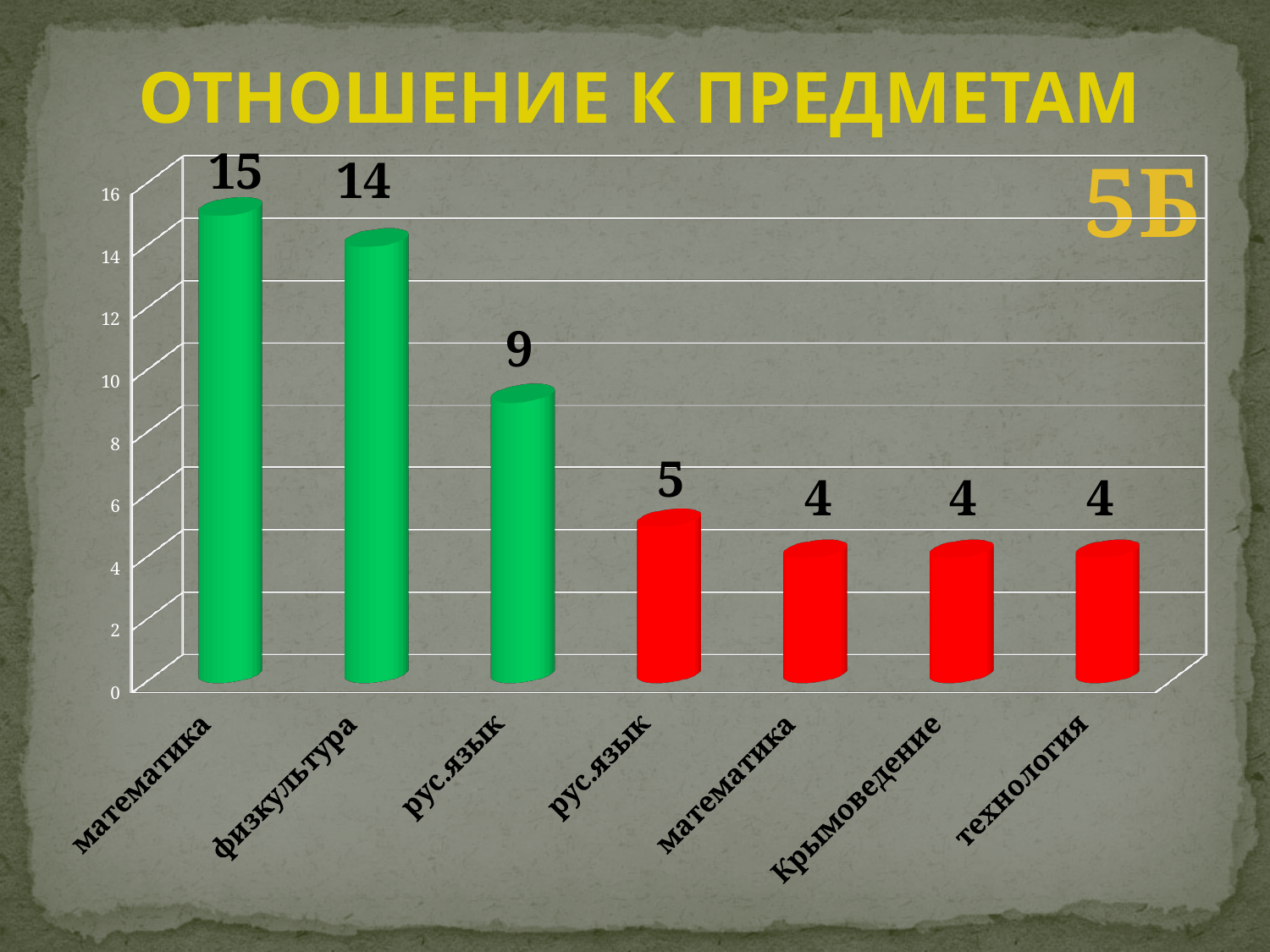
What is the title of the chart on the slide? ОТНОШЕНИЕ К ПРЕДМЕТАМ What is the value for Крымоведение? 4 Which is larger, the value for физкультура or the value for технология? физкультура What is the value of the first (leftmost) bar, labelled математика? 15 What kind of chart is shown on the slide? bar chart What is the value for физкультура? 14 What is the value for технология? 4 How many bars does the chart have? 7 What is the value of the green bar labelled рус.язык? 9 What is the difference between the value for физкультура and the green рус.язык bar? 5 Which category has the highest bar? математика (leftmost bar) What is the value of the red bar labelled рус.язык? 5